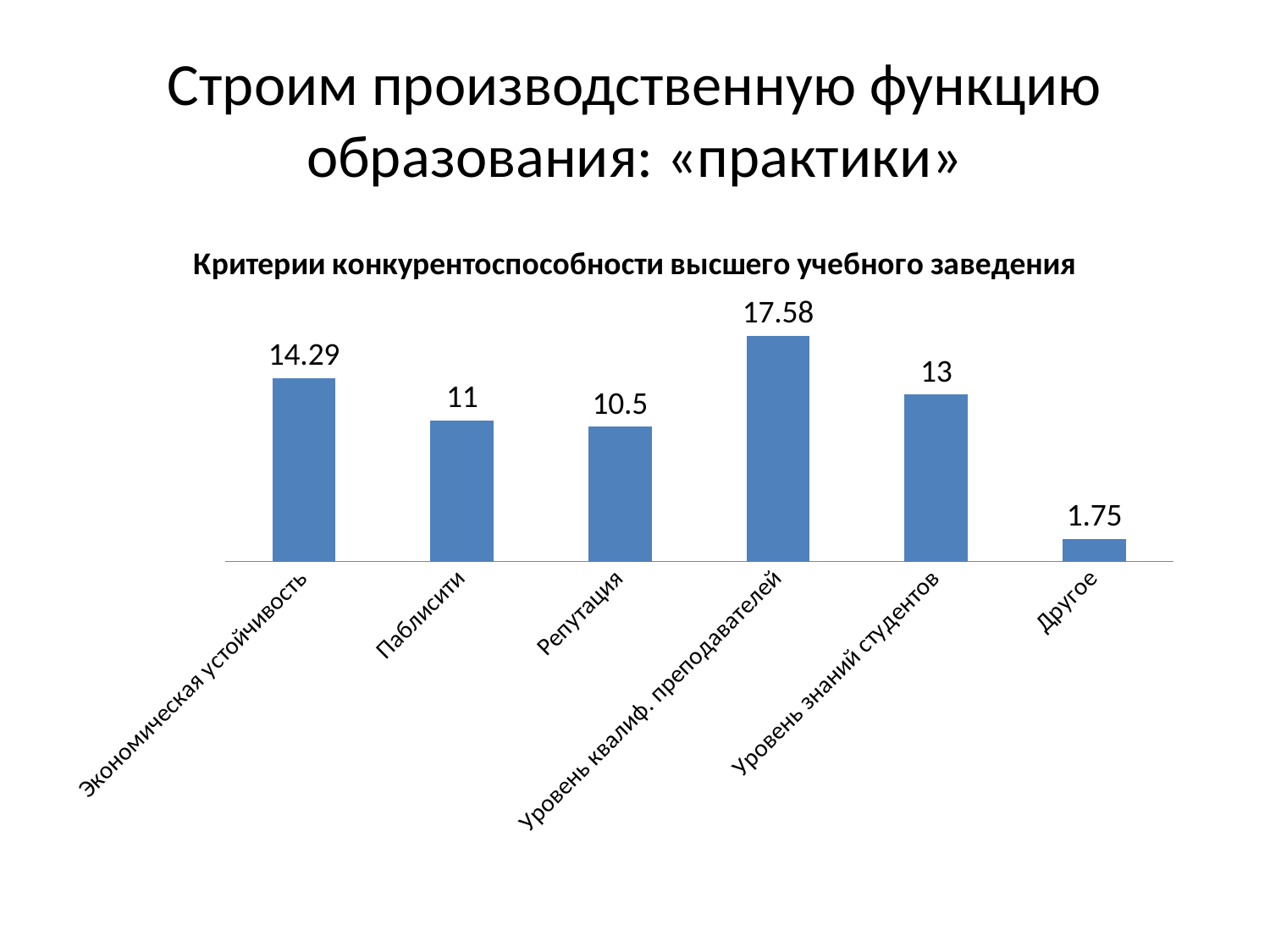
What is the value for Паблисити? 11 What is the difference between the values for Уровень квалиф. преподавателей and Экономическая устойчивость? 3.29 Which category has the highest value? Уровень квалиф. преподавателей What kind of chart is shown on the slide? Bar chart Which is larger, the value for Паблисити or the value for Репутация? Паблисити Which category has the lowest value? Другое What is the value for Уровень знаний студентов? 13 What is the value for Репутация? 10.5 How many categories are shown in the chart? 6 What is the value for Экономическая устойчивость? 14.29 What is the value for Другое? 1.75 What is the title of the chart? Критерии конкурентоспособности высшего учебного заведения